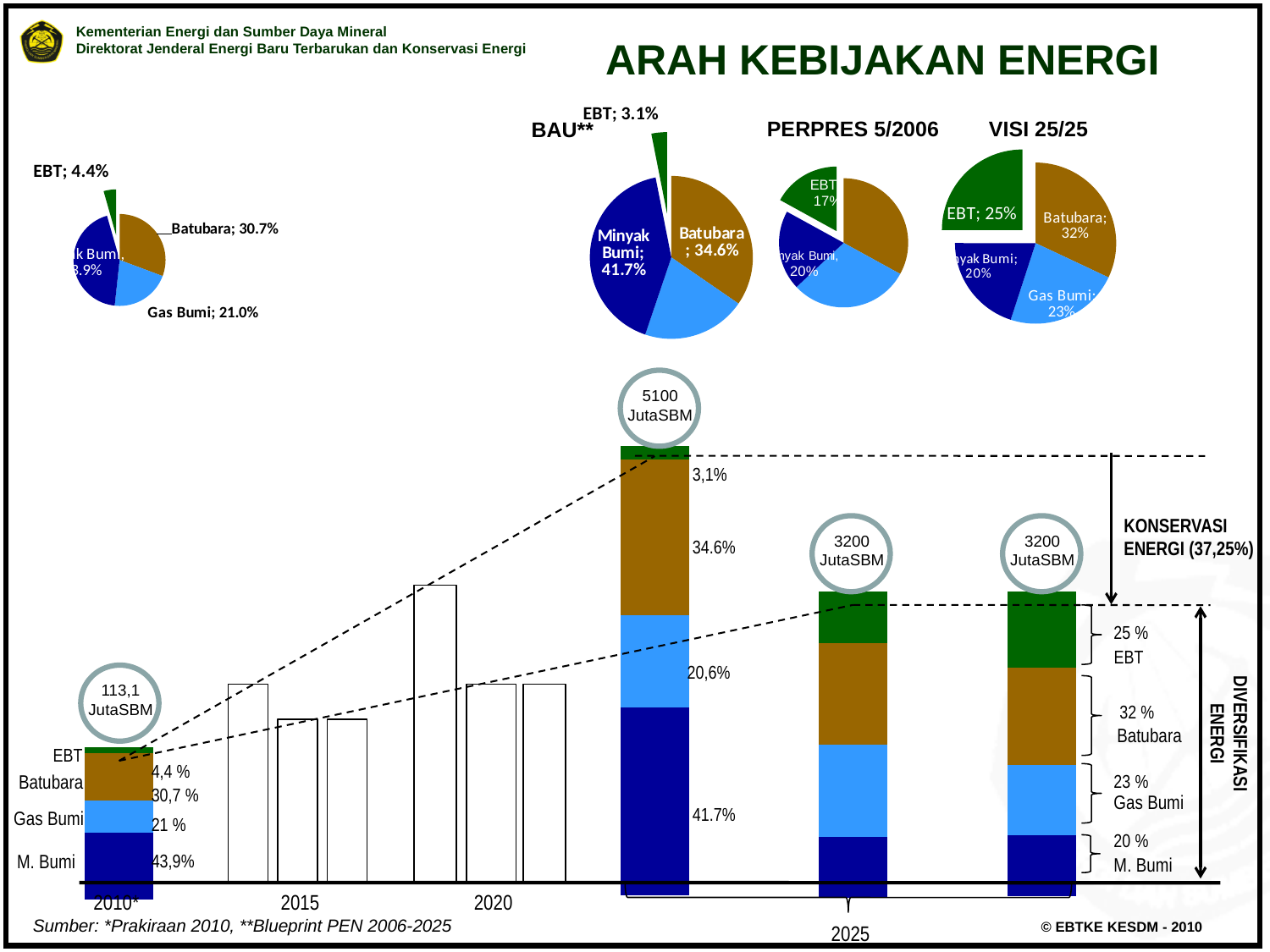
In the BAU** pie chart, what share does Minyak Bumi have? 41.7% In the VISI 25/25 pie chart, what share does Gas Bumi have? 23% In the VISI 25/25 pie chart, what share does EBT have? 25% In the top-left pie chart, what share does Batubara have? 30.7% In the VISI 25/25 pie chart, which category has the largest share? Batubara What kind of chart is the VISI 25/25 chart? Pie chart In the BAU** pie chart, what share does EBT have? 3.1% In the BAU** pie chart, what is the difference between the Minyak Bumi share and the Batubara share? 7.1% In the PERPRES 5/2006 pie chart, what share does EBT have? 17% In the VISI 25/25 pie chart, what share does Batubara have? 32% In the VISI 25/25 pie chart, which category has the smallest share? Minyak Bumi In the BAU** pie chart, what share does Batubara have? 34.6%